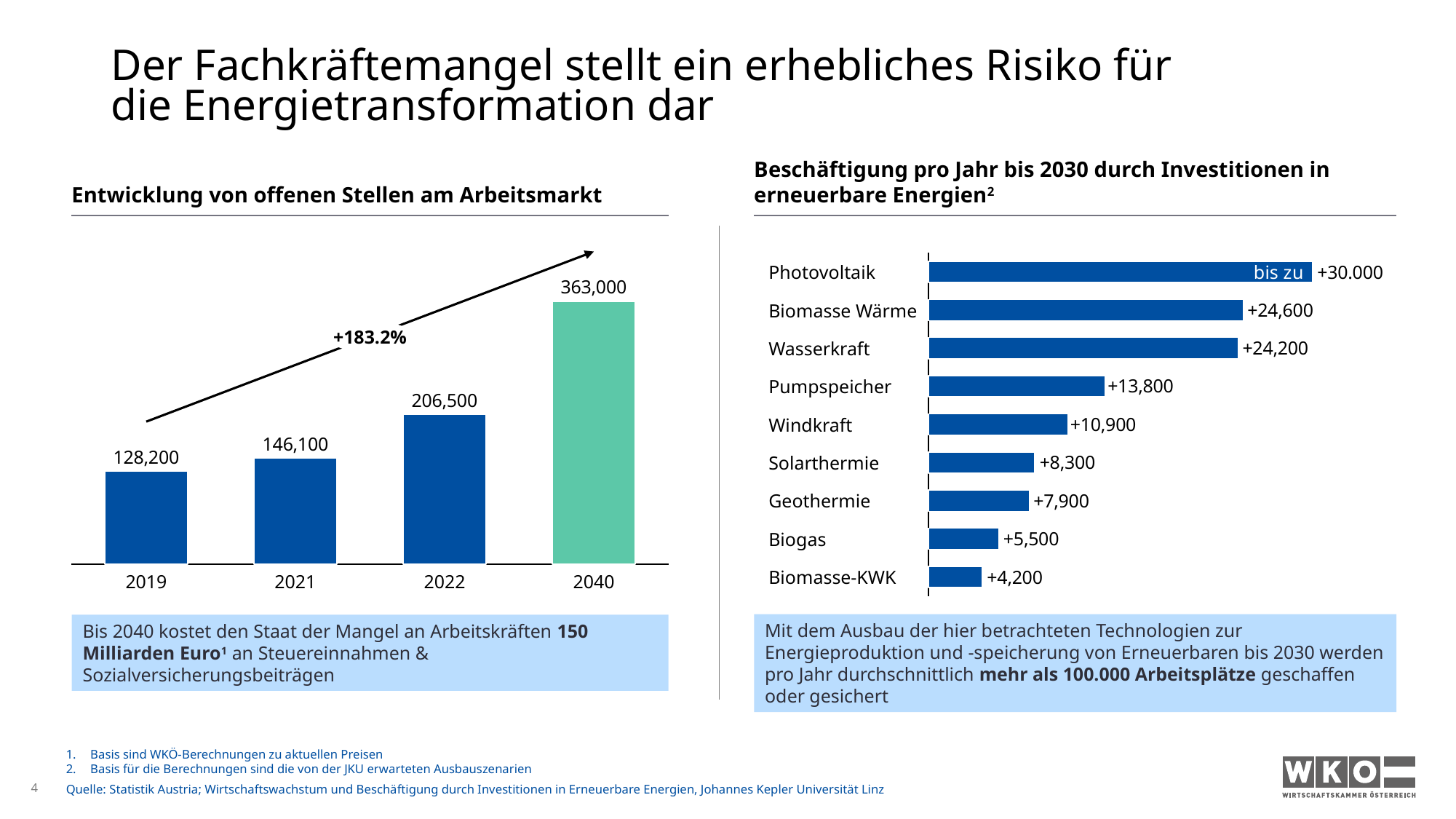
In the 'Entwicklung von offenen Stellen am Arbeitsmarkt' chart, what is the value for 2022? 206,500 In the 'Beschäftigung pro Jahr bis 2030 durch Investitionen in erneuerbare Energien' chart, which category has the lowest value? Biomasse-KWK In the 'Entwicklung von offenen Stellen am Arbeitsmarkt' chart, do the values rise or fall from 2019 to 2040? rise In the 'Beschäftigung pro Jahr bis 2030 durch Investitionen in erneuerbare Energien' chart, how many categories are shown? 9 What kind of chart is the 'Beschäftigung pro Jahr bis 2030 durch Investitionen in erneuerbare Energien' chart? bar chart In the 'Beschäftigung pro Jahr bis 2030 durch Investitionen in erneuerbare Energien' chart, what is the value for Wasserkraft? +24,200 In the 'Beschäftigung pro Jahr bis 2030 durch Investitionen in erneuerbare Energien' chart, which is larger: Pumpspeicher or Windkraft? Pumpspeicher In the 'Entwicklung von offenen Stellen am Arbeitsmarkt' chart, how many years are shown? 4 In the 'Entwicklung von offenen Stellen am Arbeitsmarkt' chart, which year has the highest value? 2040 In the 'Entwicklung von offenen Stellen am Arbeitsmarkt' chart, what percentage change is shown by the arrow? +183.2% In the 'Entwicklung von offenen Stellen am Arbeitsmarkt' chart, what is the difference between the 2021 and 2019 values? 17,900 In the 'Beschäftigung pro Jahr bis 2030 durch Investitionen in erneuerbare Energien' chart, which category has the highest value? Photovoltaik